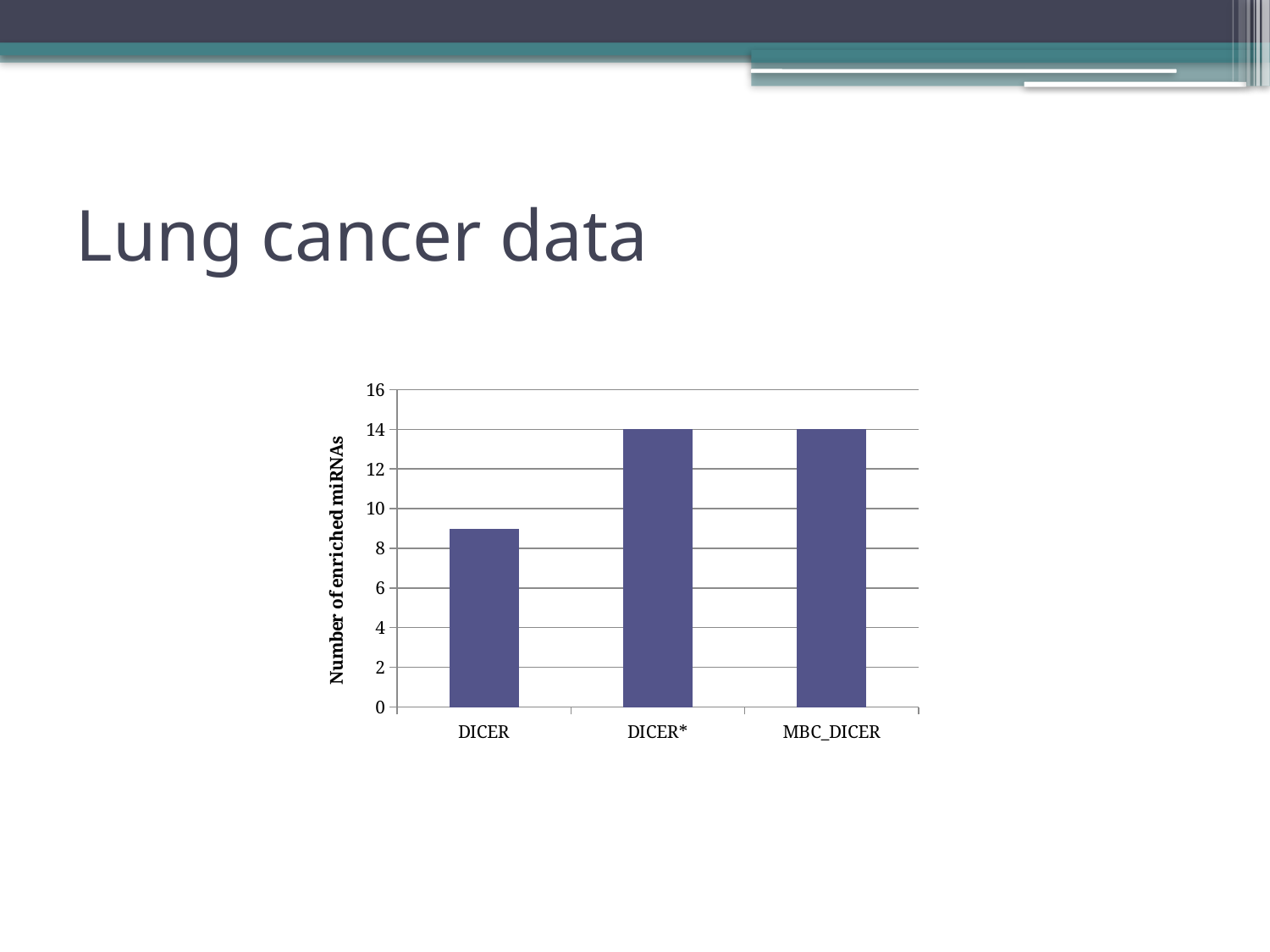
How many categories are shown on the x axis of the chart? 3 What is the title of the slide containing the chart? Lung cancer data Which is larger, the value for DICER or the value for DICER*? DICER* What is the label of the y axis of the chart? Number of enriched miRNAs What kind of chart is shown on the slide? bar chart What is the value for DICER* in the chart? 14 Is the value for DICER greater or less than 8? greater Which category has the lowest value in the chart? DICER Is the value for DICER greater or less than 10? less What is the difference between the values for DICER* and MBC_DICER? 0 Does the value rise or fall from DICER to DICER*? rise What is the value for MBC_DICER in the chart? 14